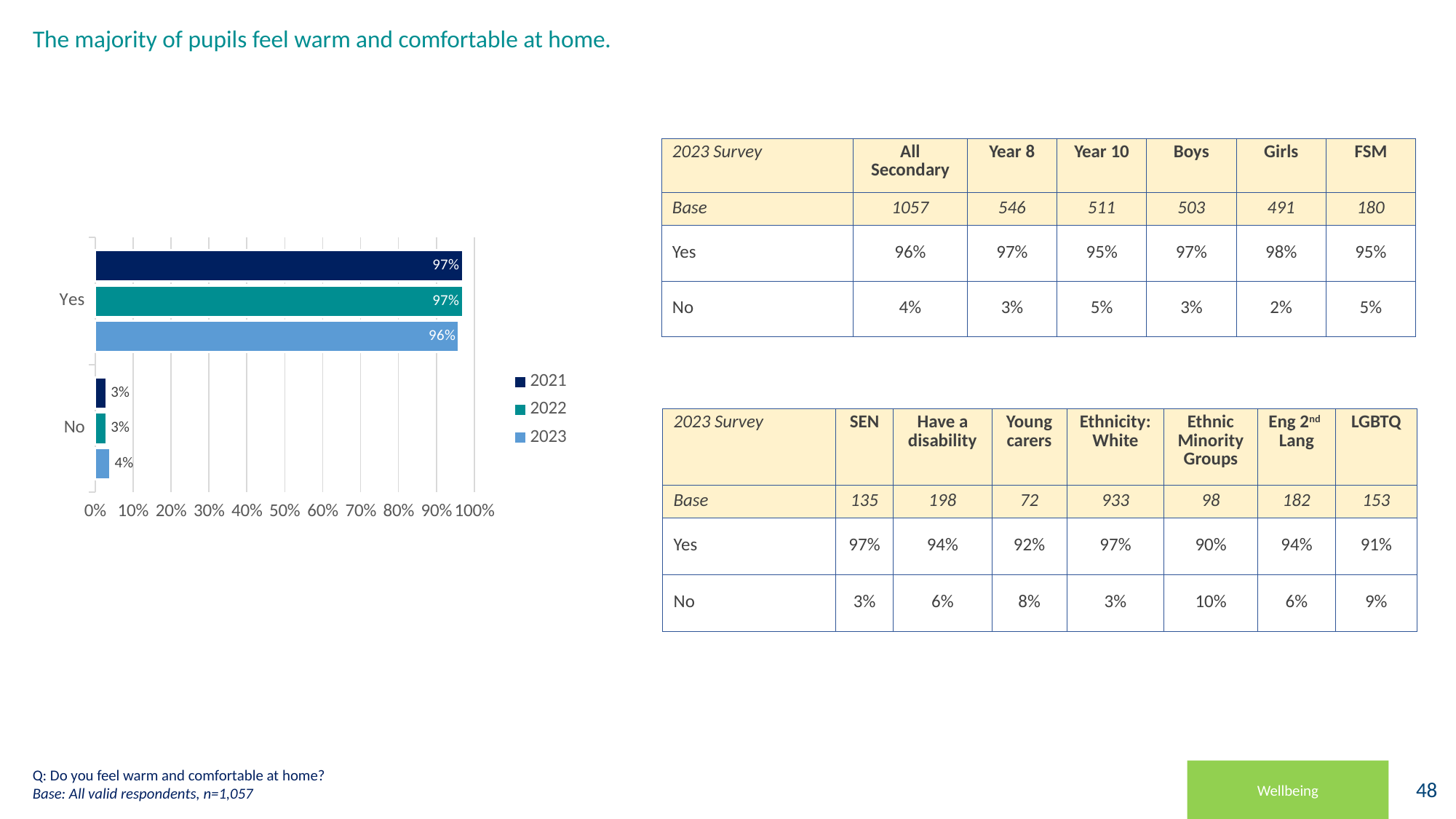
Is the No value for 2023 larger or smaller than the No value for 2022? larger How many series does the chart legend list? 3 What percentage of pupils answered No in 2023? 4% What percentage of pupils answered Yes in 2022? 97% What percentage of pupils answered No in 2021? 3% What percentage of pupils answered Yes in 2023? 96% How many response categories are shown on the chart? 2 What type of chart is shown on the slide? bar chart Which year has the highest value for No? 2023 What is the difference between the Yes value in 2021 and the Yes value in 2023? 1% Is the Yes value for 2023 greater or less than 90%? greater Which years are listed in the chart legend? 2021, 2022, 2023